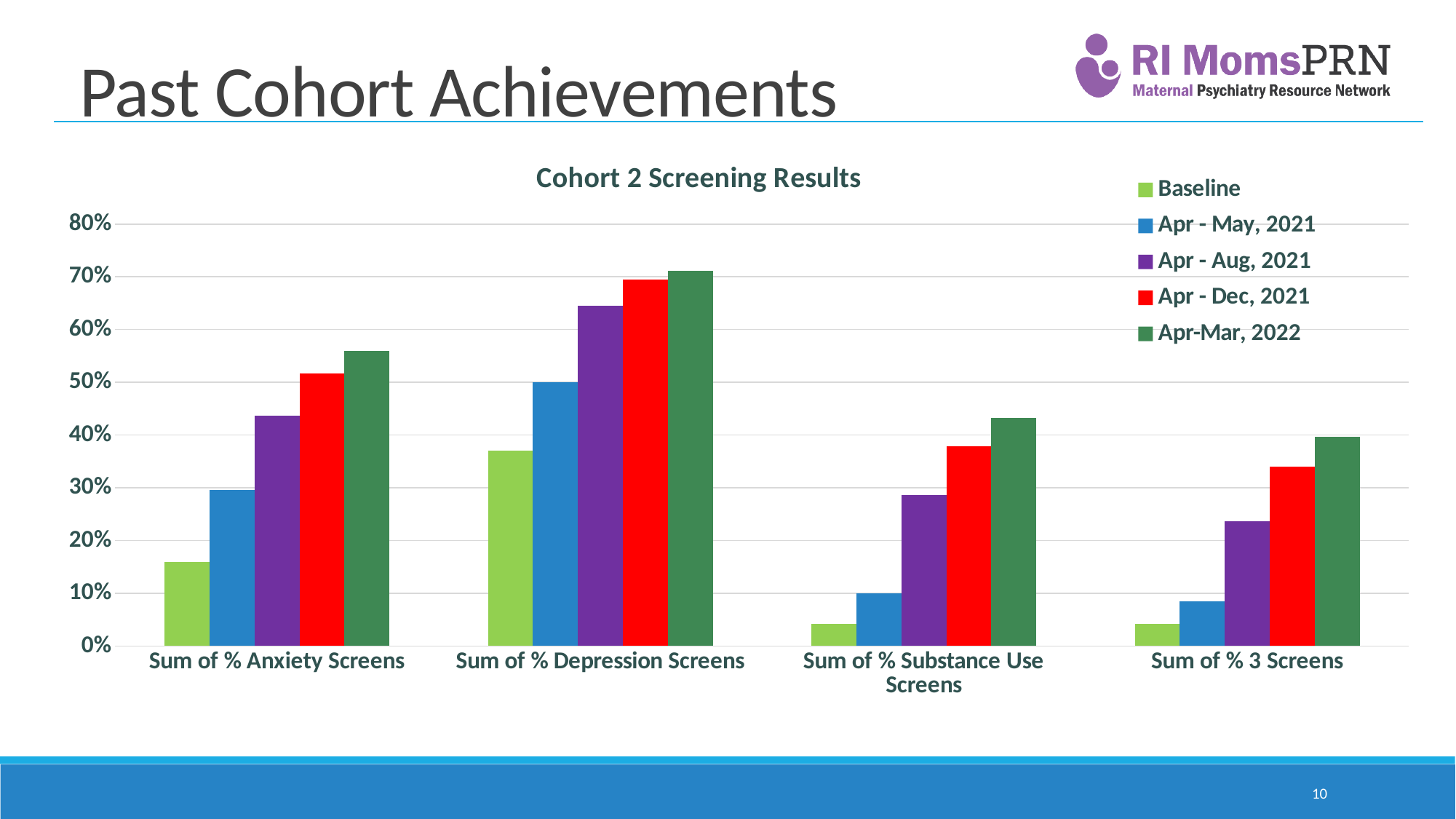
Which category has the highest Baseline bar? Sum of % Depression Screens What kind of chart is shown on the slide? Bar chart How many categories are shown along the x axis? 4 Which category has the highest Apr-Mar, 2022 bar? Sum of % Depression Screens Is the Baseline value for Sum of % Depression Screens greater or less than 40%? less What is the title of the chart? Cohort 2 Screening Results How many series does the legend list? 5 Is the Apr-Mar, 2022 value for Sum of % Anxiety Screens greater or less than 50%? greater Which is larger: the Baseline value for Sum of % Depression Screens or the Apr - May, 2021 value for Sum of % Anxiety Screens? Baseline value for Sum of % Depression Screens Is the Baseline value for Sum of % Anxiety Screens greater or less than 20%? less Within each category, do the values rise or fall from Baseline to Apr-Mar, 2022? rise